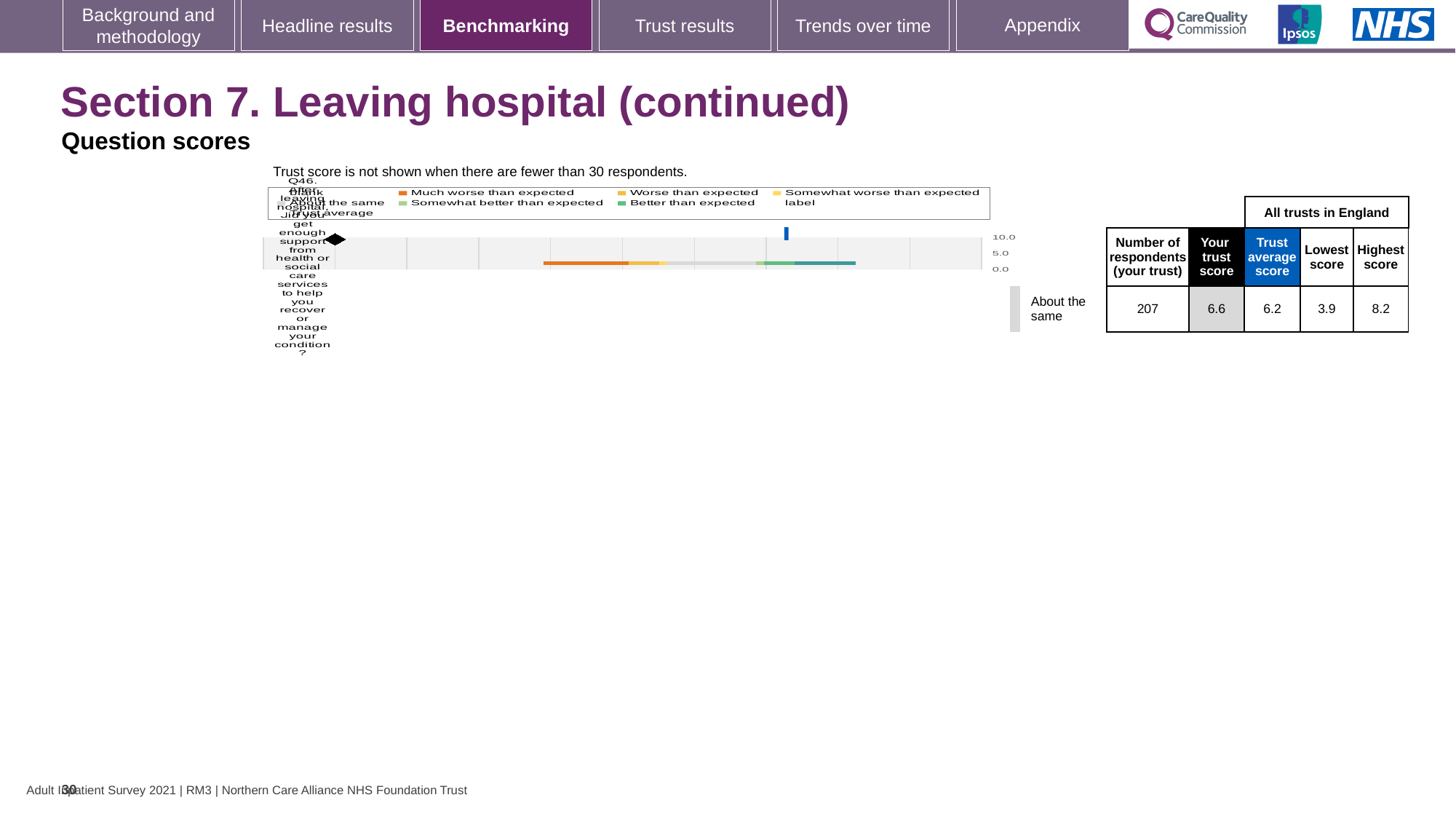
What kind of chart is used to show the Q46 benchmarking result? Bar chart Is the trust's score for Q46 greater or less than 5.0 on the chart axis? greater Which is larger for Q46: the trust's own score or the trust average score? Your trust score How is the trust's Q46 result categorised relative to expectations on the slide? About the same How many respondents from the trust answered Q46? 207 By how much does the trust's score for Q46 exceed the trust average score? 0.4 What is the lowest score among all trusts in England for Q46? 3.9 What is the trust average score for Q46 across all trusts in England? 6.2 What is the difference between the highest score and the lowest score for Q46? 4.3 What is the 'Your trust score' value for Q46 shown on the slide? 6.6 What is the highest score among all trusts in England for Q46? 8.2 How many questions are plotted on the benchmarking chart on this slide? 1